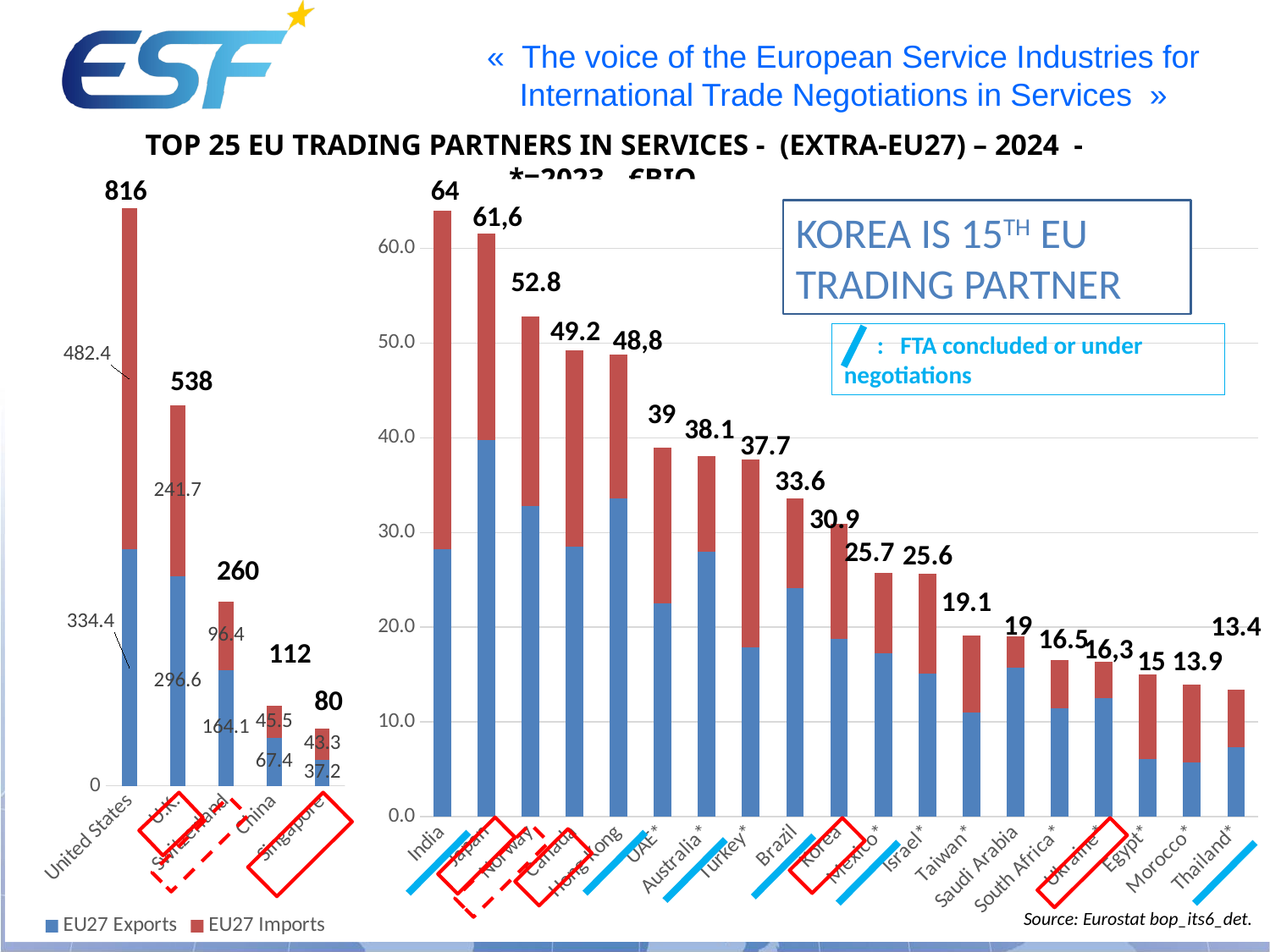
On the left chart, what is the EU27 Imports value for Switzerland? 96.4 On the left chart, which country has the lowest total? Singapore On the left chart, what is the total value shown for United States? 816 On the left chart, what is the EU27 Exports value for the U.K.? 296.6 On the right chart, which country has the highest total? India On the right chart, what is the total value shown for Korea? 30.9 On the right chart, do the totals rise or fall from India to Thailand? fall On the left chart, what is the difference between the totals for United States and U.K.? 278 On the right chart, which is larger, the total for Norway or the total for Canada? Norway How many series does the legend list? 2 On the right chart, is the total for Brazil greater or less than 30.0? greater On the left chart, how many countries are shown? 5